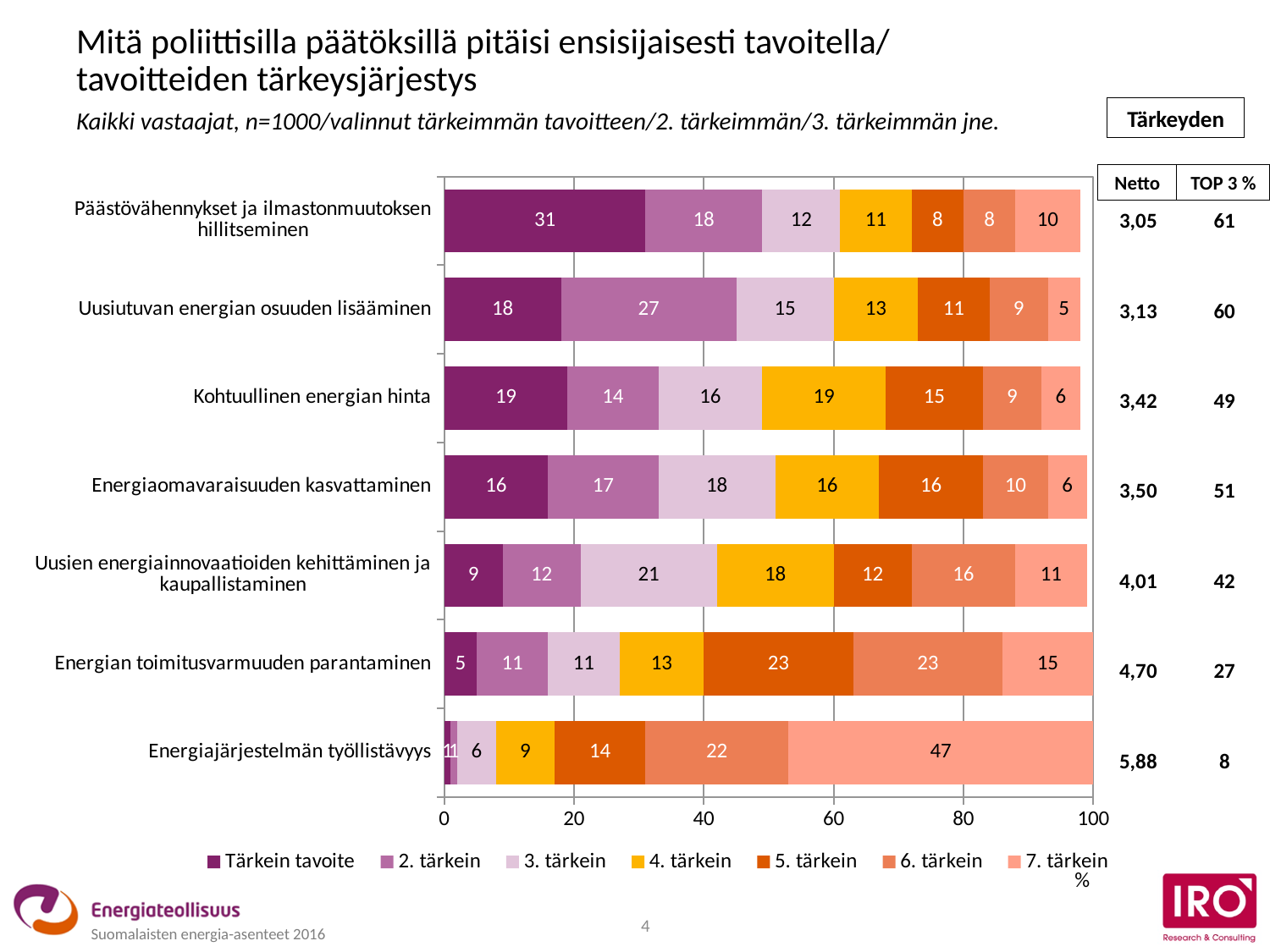
How many categories are shown on the chart? 7 What is the value of the 'Tärkein tavoite' segment for 'Päästövähennykset ja ilmastonmuutoksen hillitseminen'? 31 Which category has the highest 'Tärkein tavoite' value? Päästövähennykset ja ilmastonmuutoksen hillitseminen Which category has the lowest 'Tärkein tavoite' value? Energiajärjestelmän työllistävyys Which has the larger '5. tärkein' value: 'Energian toimitusvarmuuden parantaminen' or 'Kohtuullinen energian hinta'? Energian toimitusvarmuuden parantaminen How many series does the legend list? 7 What is the total of the stacked bar for 'Päästövähennykset ja ilmastonmuutoksen hillitseminen'? 98 What is the value of the '7. tärkein' segment for 'Energiajärjestelmän työllistävyys'? 47 What is the first entry in the chart legend? Tärkein tavoite What is the value of the '3. tärkein' segment for 'Uusien energiainnovaatioiden kehittäminen ja kaupallistaminen'? 21 What is the difference between the '2. tärkein' values for 'Uusiutuvan energian osuuden lisääminen' and 'Päästövähennykset ja ilmastonmuutoksen hillitseminen'? 9 What kind of chart is shown on the slide? Stacked bar chart